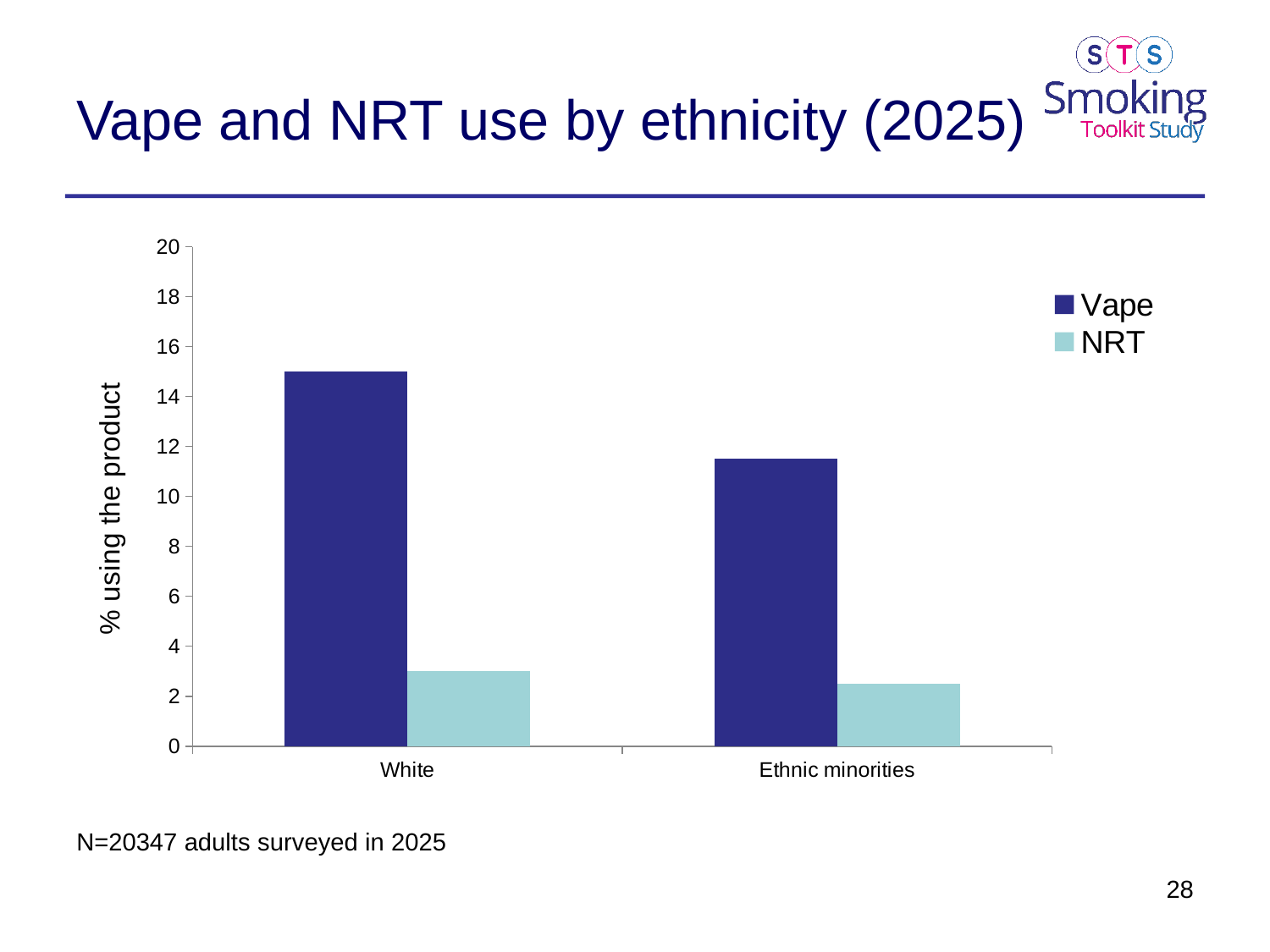
Is the NRT value for Ethnic minorities greater or less than 2? greater Which category has the higher Vape value, White or Ethnic minorities? White For Ethnic minorities, which is larger, the Vape value or the NRT value? Vape Is the Vape value for White greater or less than 16? less How many categories are shown on the x axis? 2 Is the Vape value for Ethnic minorities greater or less than 10? greater What is the label on the y axis? % using the product How many series does the legend list? 2 What kind of chart is shown on the slide? bar chart